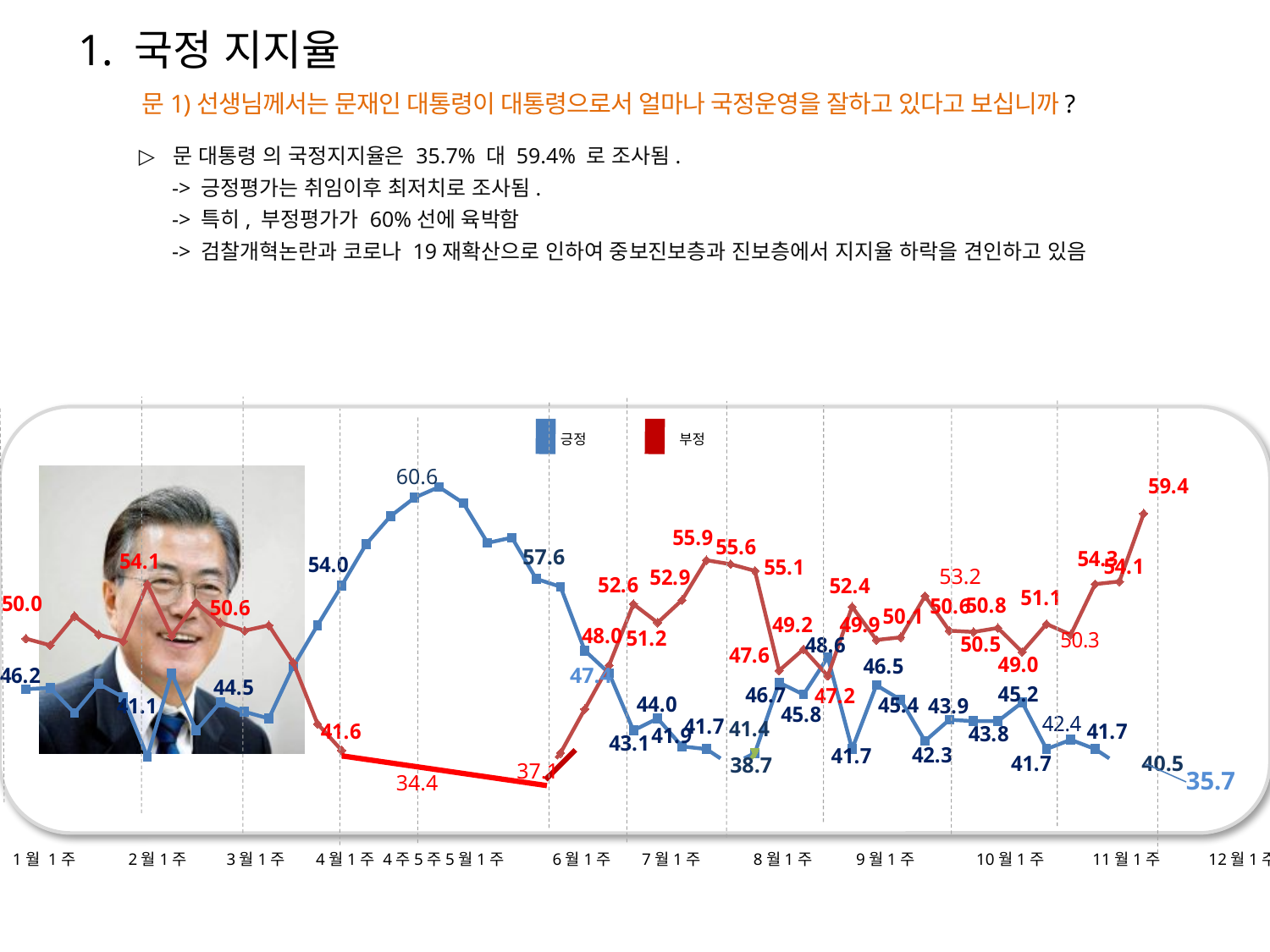
What is the difference between the final 부정 value (59.4) and the final 긍정 value (35.7)? 23.7 What is the lowest value reached by the 긍정 (blue) line? 35.7 What is the 부정 value at the first point of the chart (1월 1주)? 50.0 At the last point of the chart, which series is higher, 긍정 or 부정? 부정 What kind of chart is shown on the slide? line chart How many series does the chart's legend list? 2 What is the highest value reached by the 부정 (red) line? 59.4 What are the two series named in the chart's legend? 긍정 and 부정 What is the 긍정 value at the first point of the chart (1월 1주)? 46.2